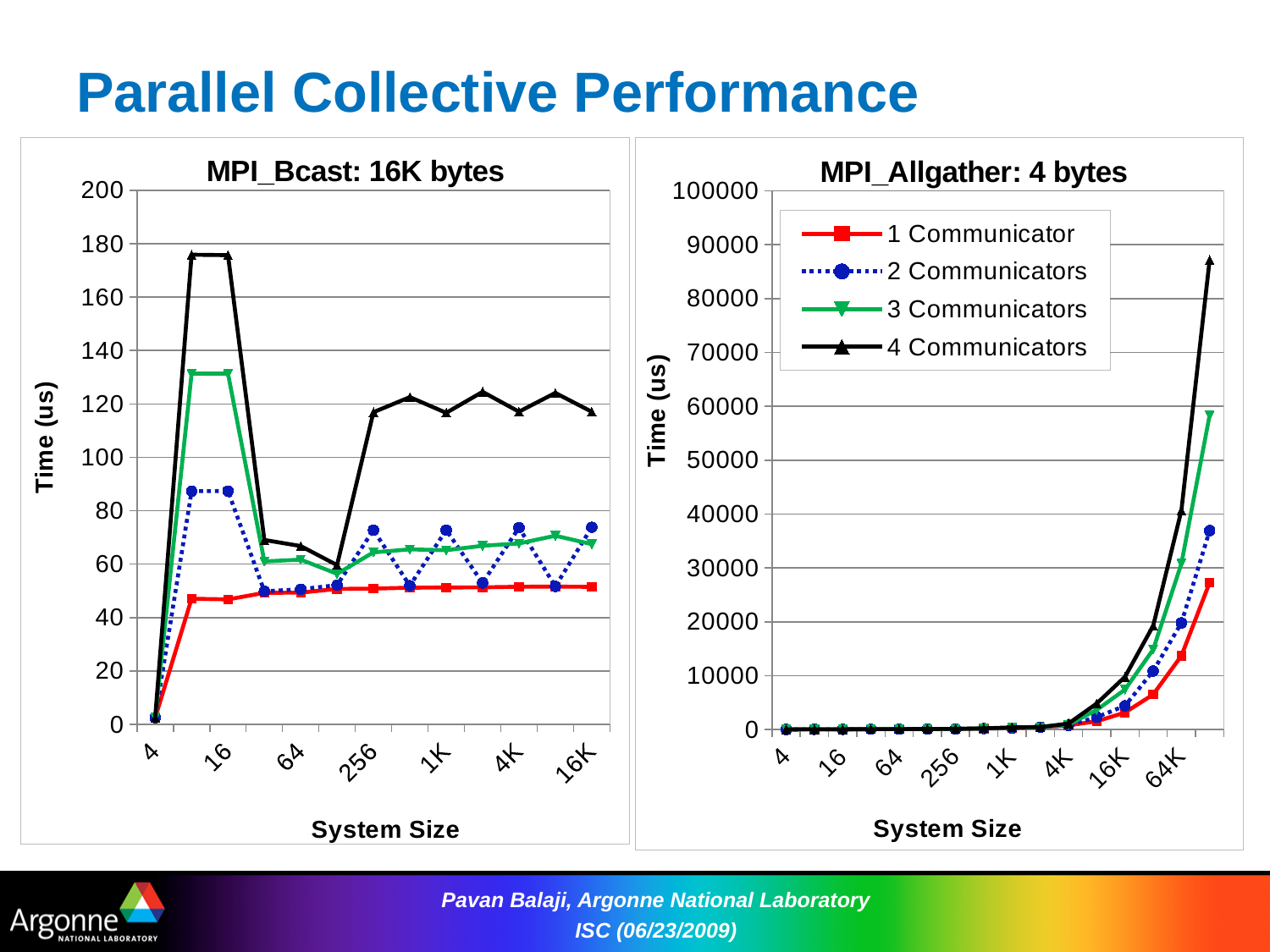
In the MPI_Allgather: 4 bytes chart, is the highest value for 4 Communicators greater or less than 80000? greater In the MPI_Bcast: 16K bytes chart, which series reaches the highest value? 4 Communicators In the MPI_Bcast: 16K bytes chart, is the value for 3 Communicators at system size 16 greater or less than 120? greater How many series does the legend on the MPI_Allgather: 4 bytes chart list? 4 What is the y-axis label of the MPI_Bcast: 16K bytes chart? Time (us) How many labelled tick marks are on the x axis of the MPI_Allgather: 4 bytes chart? 8 In the MPI_Allgather: 4 bytes chart, at the largest system size, which series has the larger value: 4 Communicators or 1 Communicator? 4 Communicators What kind of chart is the MPI_Bcast: 16K bytes chart? line chart In the MPI_Bcast: 16K bytes chart, is the value for 1 Communicator at system size 16K greater or less than 60? less In the MPI_Allgather: 4 bytes chart, do the values for 4 Communicators rise or fall as system size increases beyond 4K? rise